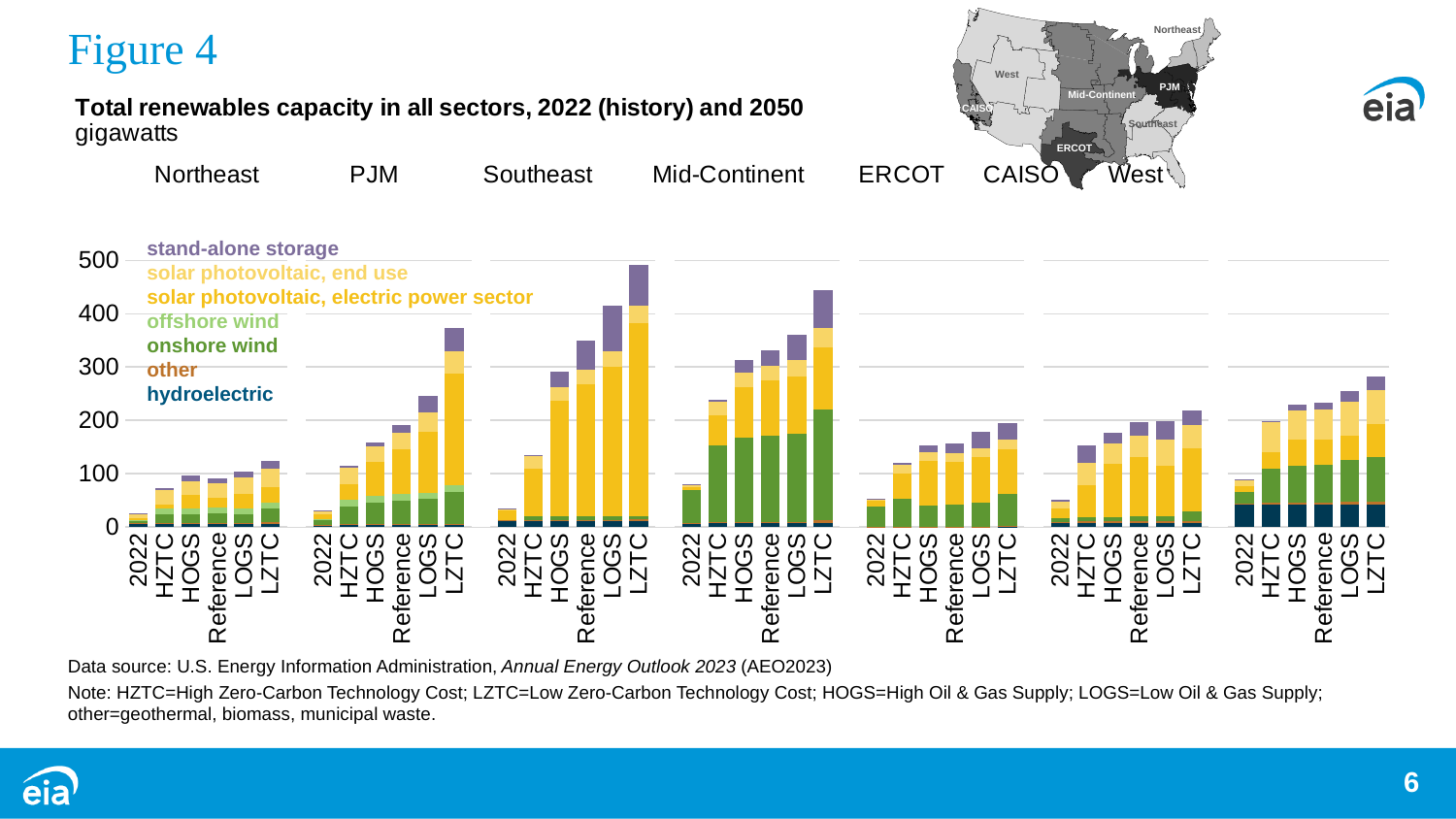
What unit is the chart's y axis measured in? gigawatts Is the total value of the Northeast 2022 bar greater or less than 100? less What kind of chart is shown on the slide? stacked bar chart Which region has the tallest LZTC bar? Southeast How many regions are shown as separate panels in the chart? 7 How many series does the chart legend list? 7 Which is larger, the LZTC bar for Southeast or the LZTC bar for PJM? Southeast Is the total value of the Southeast LZTC bar greater or less than 400? greater Within the Southeast panel, which case has the lowest total renewables capacity? 2022 Is the total value of the ERCOT 2022 bar greater or less than 100? less How many bars are plotted for the Southeast region? 6